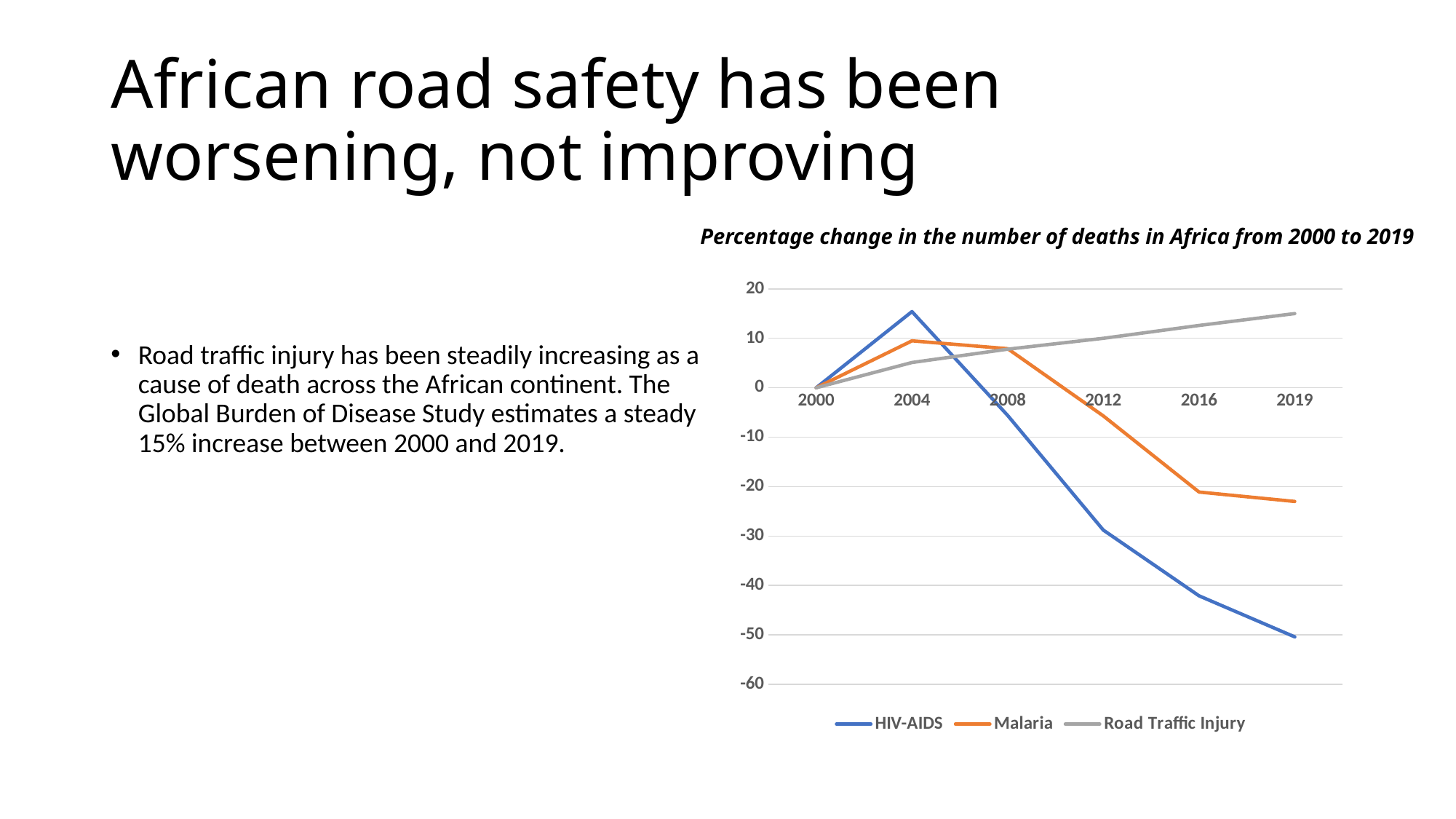
Which series has the highest value in 2004? HIV-AIDS How many series does the chart's legend list? 3 Which series has the lowest value in 2019? HIV-AIDS How many years are marked along the x axis of the chart? 6 What kind of chart is shown on the slide? line chart What is the title of the chart? Percentage change in the number of deaths in Africa from 2000 to 2019 Does the Road Traffic Injury line rise or fall from 2000 to 2019? rise Which series has the highest value in 2019? Road Traffic Injury Is the value for HIV-AIDS in 2012 greater or less than -20? less What is the value for Road Traffic Injury in 2000? 0 What colour is the Malaria line in the chart? orange Is the value for Road Traffic Injury in 2019 greater or less than 10? greater